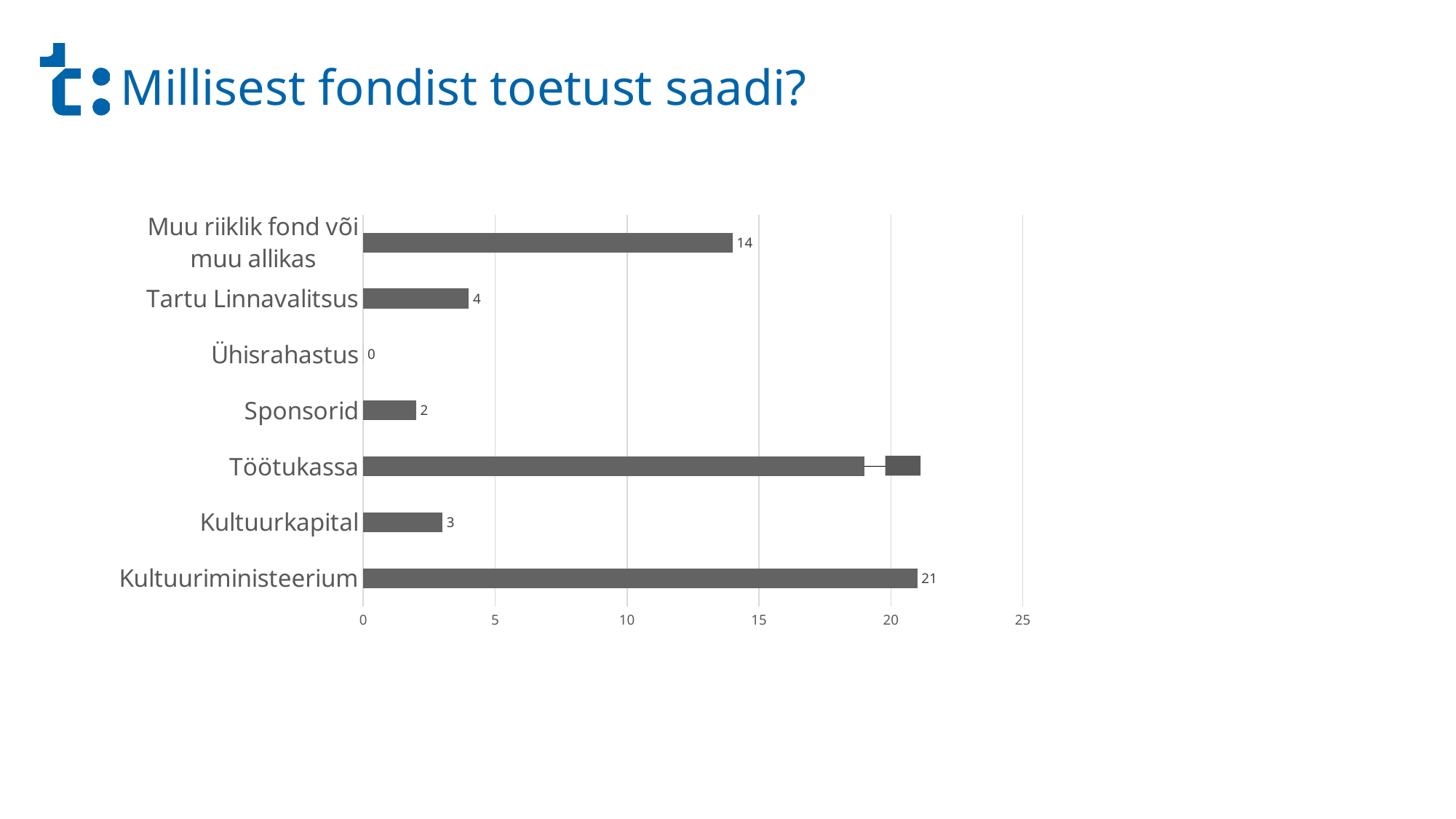
Which is larger, the value for Kultuurkapital or the value for Sponsorid? Kultuurkapital What is the value for Kultuuriministeerium? 21 What kind of chart is shown on the slide? bar chart What is the title of the slide? Millisest fondist toetust saadi? Which category has the lowest value? Ühisrahastus What is the value for Kultuurkapital? 3 Is the value for Töötukassa greater or less than 15? greater What is the value for Sponsorid? 2 How many categories are shown in the chart? 7 What is the value for Tartu Linnavalitsus? 4 What is the difference between the values for Muu riiklik fond või muu allikas and Tartu Linnavalitsus? 10 What is the value for Muu riiklik fond või muu allikas? 14